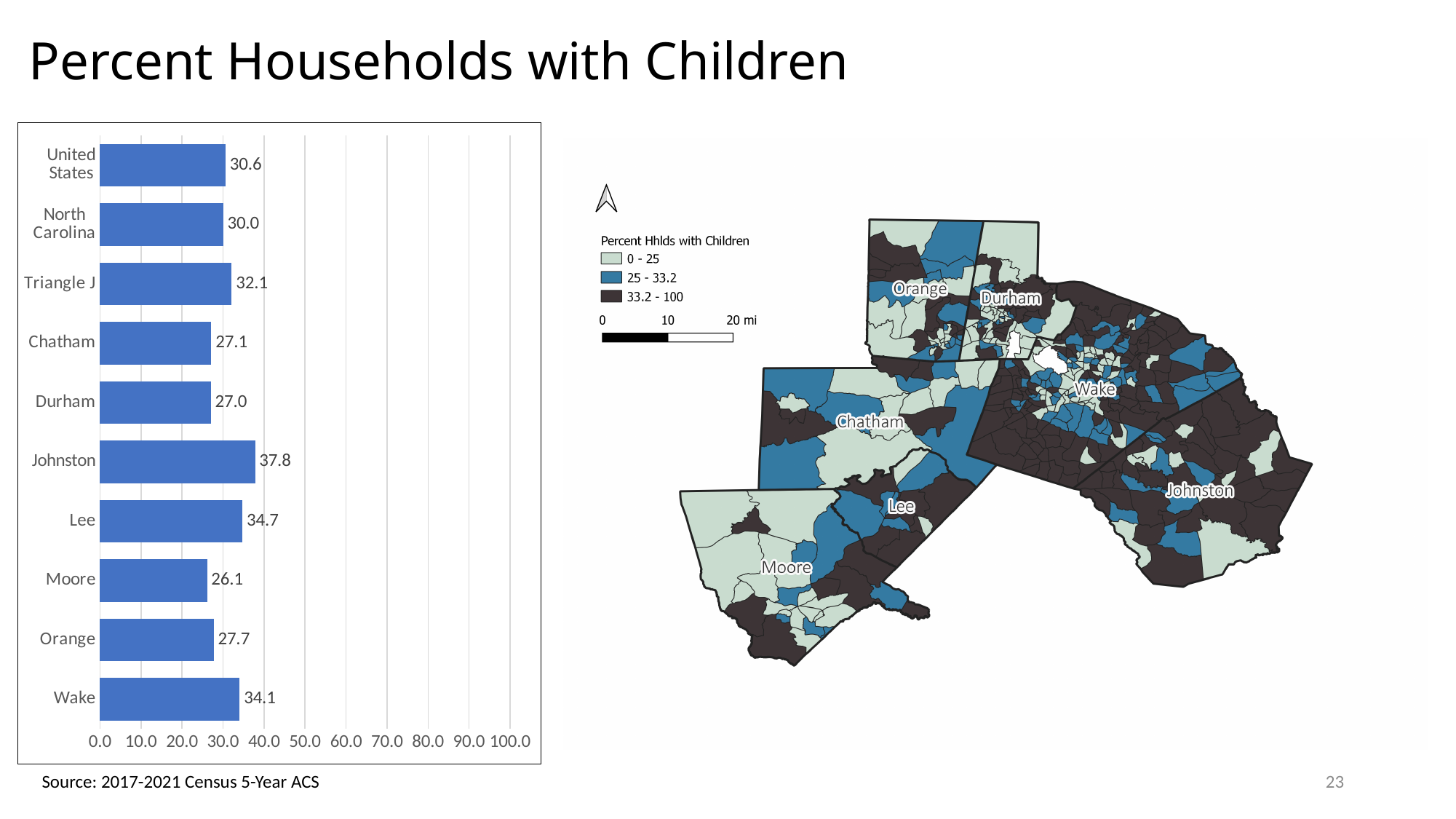
In the bar chart, what value is shown for Triangle J? 32.1 In the bar chart, which category has the highest percent of households with children? Johnston How many categories are shown in the bar chart? 10 How many value ranges does the map legend 'Percent Hhlds with Children' list? 3 In the bar chart, what value is shown for Wake? 34.1 What kind of chart is shown on the left of the slide? bar chart In the bar chart, what value is shown for North Carolina? 30.0 In the bar chart, what is the percent of households with children for Johnston? 37.8 In the bar chart, which category has the lowest percent of households with children? Moore In the bar chart, what is the difference between the values for Johnston and Wake? 3.7 In the bar chart, which has a higher value, Wake or Orange? Wake In the bar chart, what is the difference between the values for Lee and Moore? 8.6